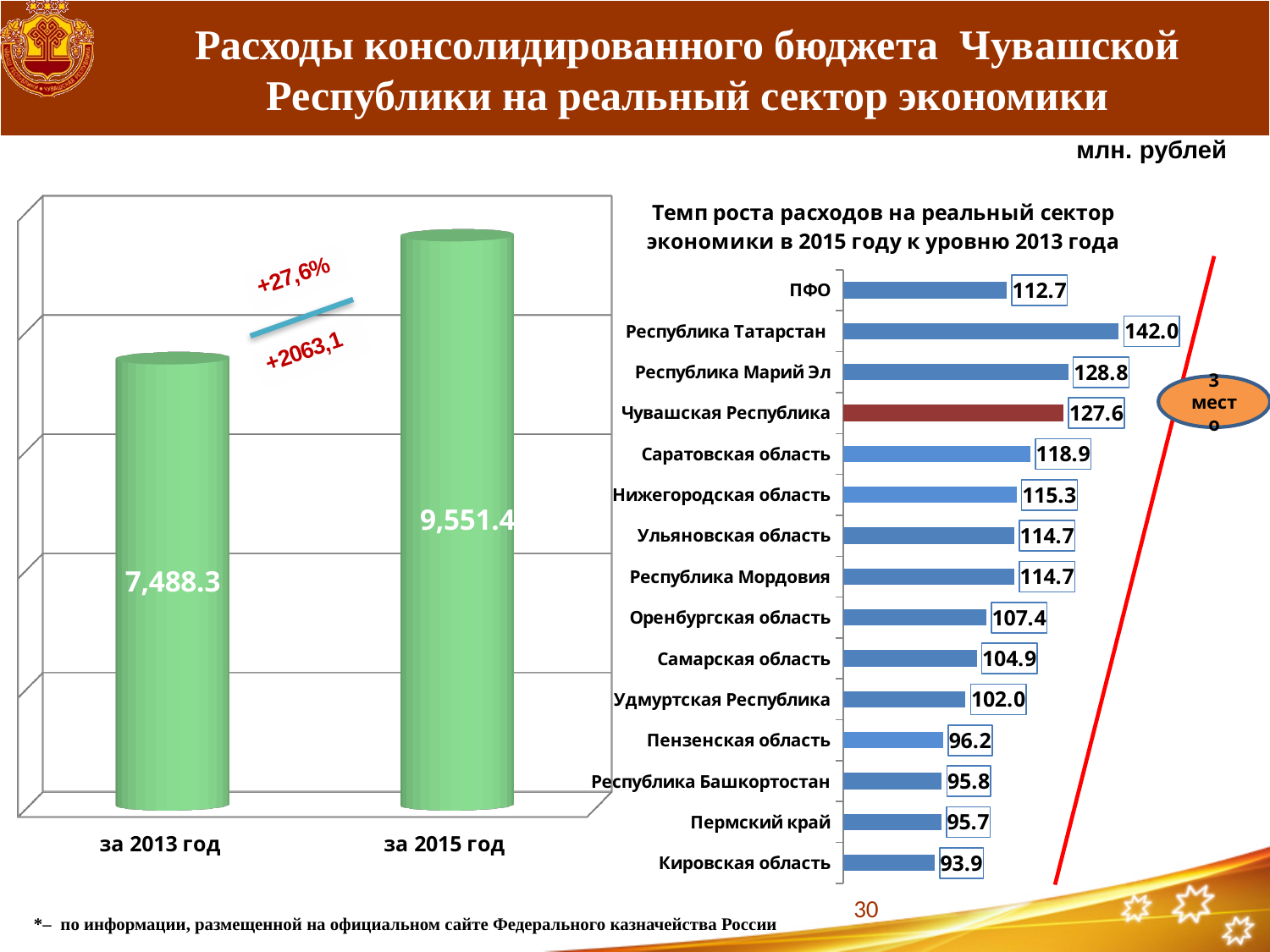
On the chart 'Темп роста расходов на реальный сектор экономики в 2015 году к уровню 2013 года', what is the value for ПФО? 112.7 On the chart 'Темп роста расходов на реальный сектор экономики в 2015 году к уровню 2013 года', which is larger: Республика Марий Эл or Саратовская область? Республика Марий Эл On the chart 'Темп роста расходов на реальный сектор экономики в 2015 году к уровню 2013 года', what is the difference between Республика Татарстан and Чувашская Республика? 14.4 On the left chart, how many bars are plotted? 2 On the chart 'Темп роста расходов на реальный сектор экономики в 2015 году к уровню 2013 года', how many categories are plotted? 15 On the left chart, what is the value for 'за 2013 год'? 7,488.3 On the left chart, what is the value for 'за 2015 год'? 9,551.4 On the chart 'Темп роста расходов на реальный сектор экономики в 2015 году к уровню 2013 года', which category has the lowest value? Кировская область On the left chart, what is the difference between the 2015 and 2013 values? 2,063.1 On the chart 'Темп роста расходов на реальный сектор экономики в 2015 году к уровню 2013 года', which category has the highest value? Республика Татарстан On the chart 'Темп роста расходов на реальный сектор экономики в 2015 году к уровню 2013 года', what is the value for Чувашская Республика? 127.6 On the left chart, do the values rise or fall from 2013 to 2015? rise